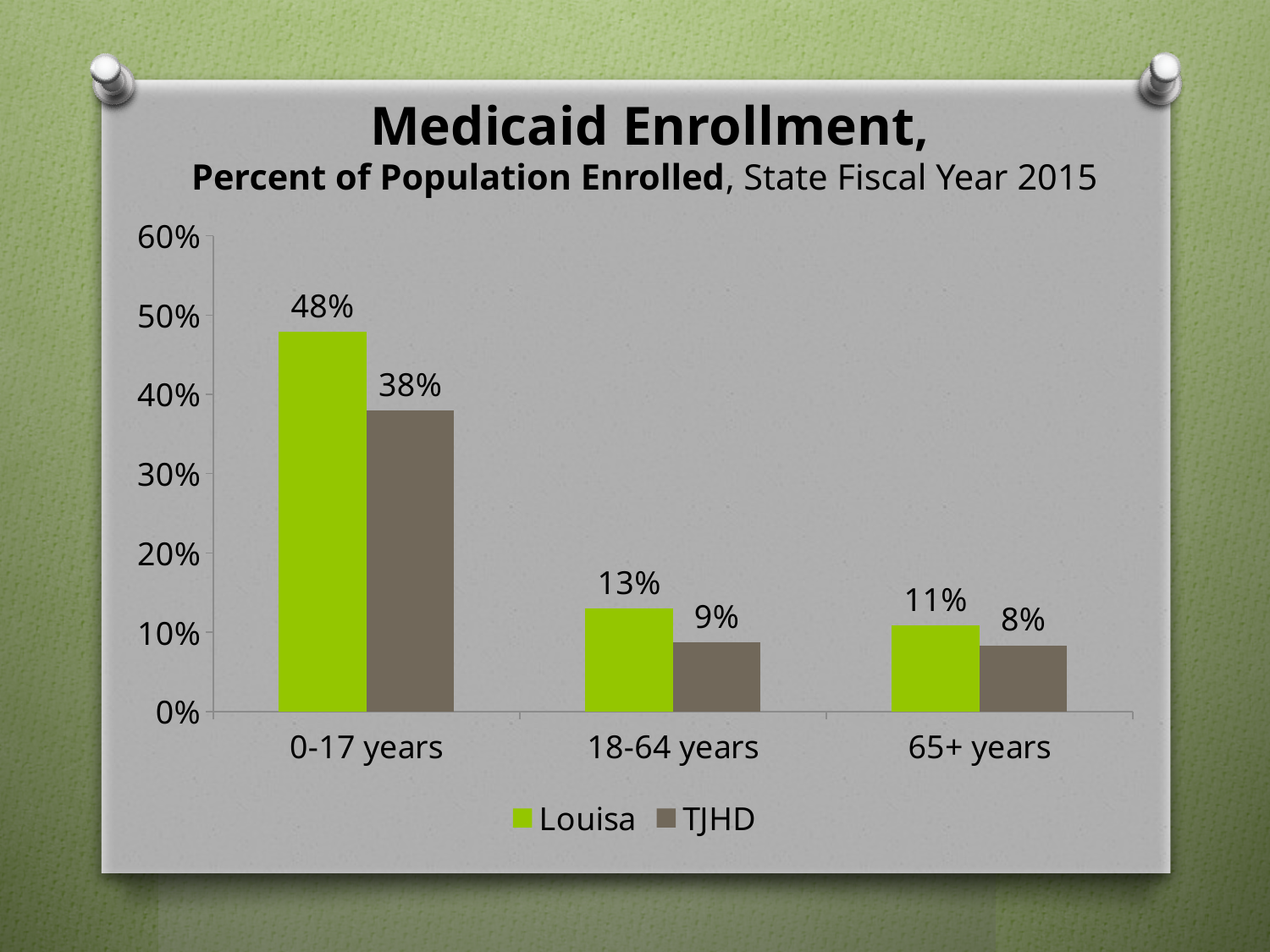
Which age group has the lowest Louisa value? 65+ years How many series does the legend list? 2 What is the Louisa value for 0-17 years? 48% What is the difference between the Louisa and TJHD values for 0-17 years? 10% How many age groups are shown on the x axis? 3 What is the TJHD value for 18-64 years? 9% What is the difference between the Louisa values for 18-64 years and 65+ years? 2% What kind of chart is shown? Bar chart Which colour represents TJHD in the legend? Brown/grey Which age group has the highest TJHD value? 0-17 years For 65+ years, which is larger, Louisa or TJHD? Louisa What is the Louisa value for 65+ years? 11%